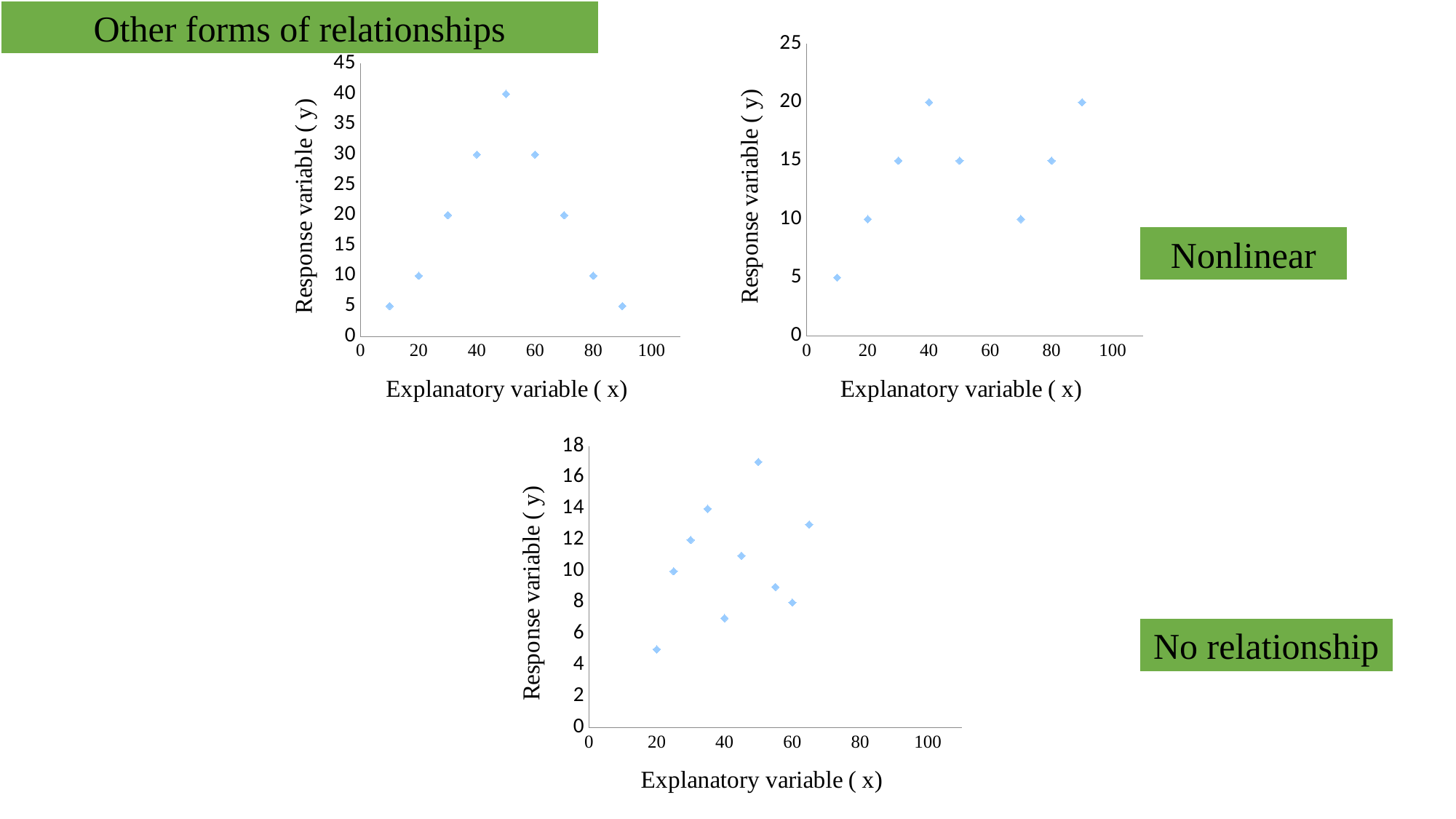
How many data points are plotted in the top-right chart (labelled Nonlinear)? 8 How many data points are plotted in the top-left chart? 9 What label is shown in the green box next to the top-right chart? Nonlinear In the top-left chart, at which x value does the highest response value occur? 50 How many data points are plotted in the bottom chart (labelled No relationship)? 10 What kind of chart is the top-left chart? scatter chart In the top-right chart, is the response value at x = 10 greater or less than 10? less In the bottom chart, is the response value at x = 50 greater or less than 14? greater In the bottom chart, which point has the larger response value: the one at x = 20 or the one at x = 35? x = 35 What is the label on the vertical axis of the bottom chart? Response variable ( y) In the top-left chart, is the response value at x = 50 greater or less than 35? greater